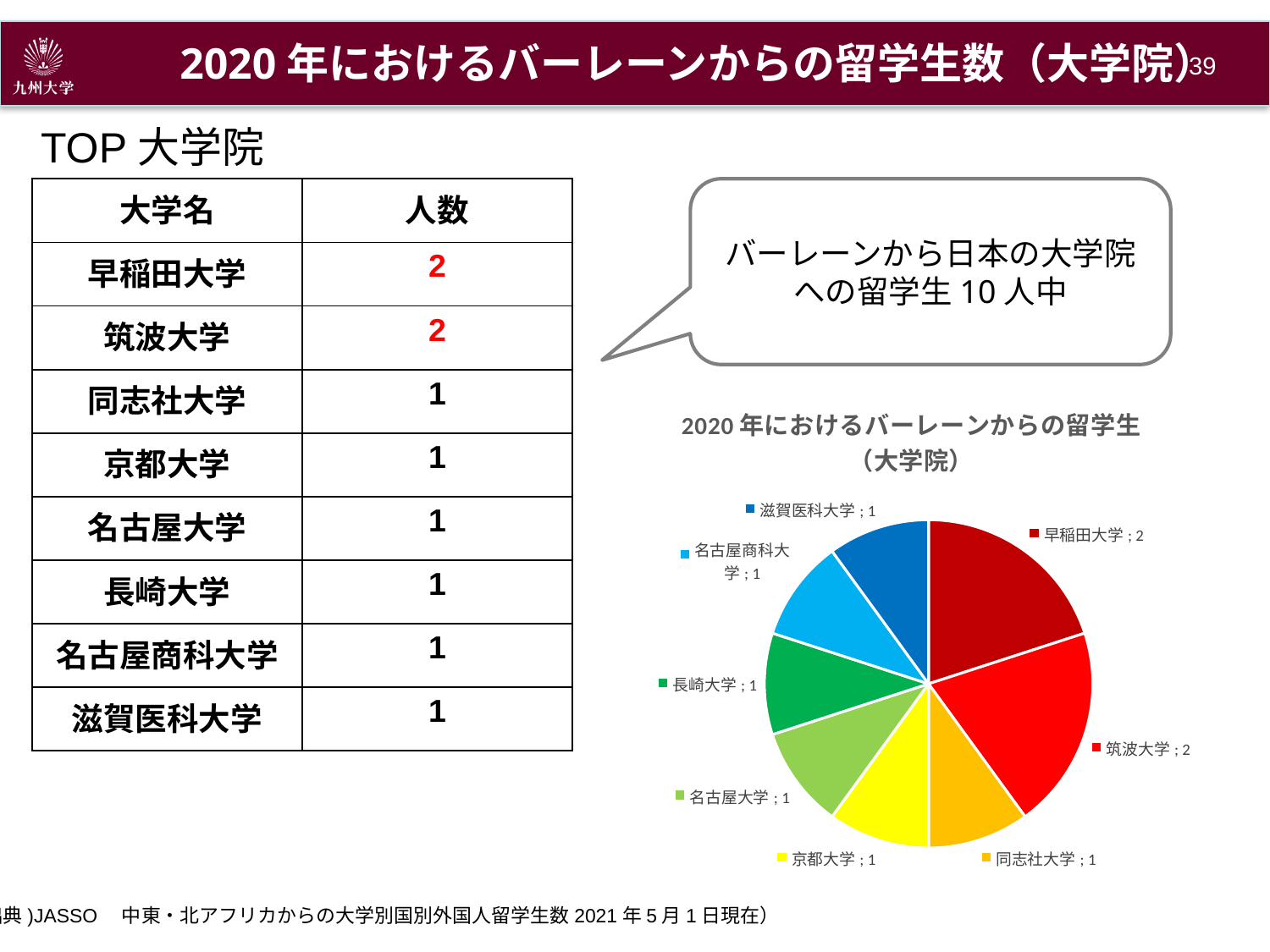
What is the title of the pie chart? 2020年におけるバーレーンからの留学生（大学院） What is the difference between the values for 早稲田大学 and 京都大学 in the pie chart? 1 What share of the pie does 早稲田大学 represent? 20% Which is larger in the pie chart, the value for 筑波大学 or the value for 同志社大学? 筑波大学 How many slices does the pie chart have? 8 What is the total of all the values shown in the pie chart? 10 What is the value for 早稲田大学 in the pie chart? 2 What kind of chart is shown on the slide? pie chart What is the value for 筑波大学 in the pie chart? 2 What is the value for 滋賀医科大学 in the pie chart? 1 What share of the pie does 名古屋大学 represent? 10% What is the value for 長崎大学 in the pie chart? 1